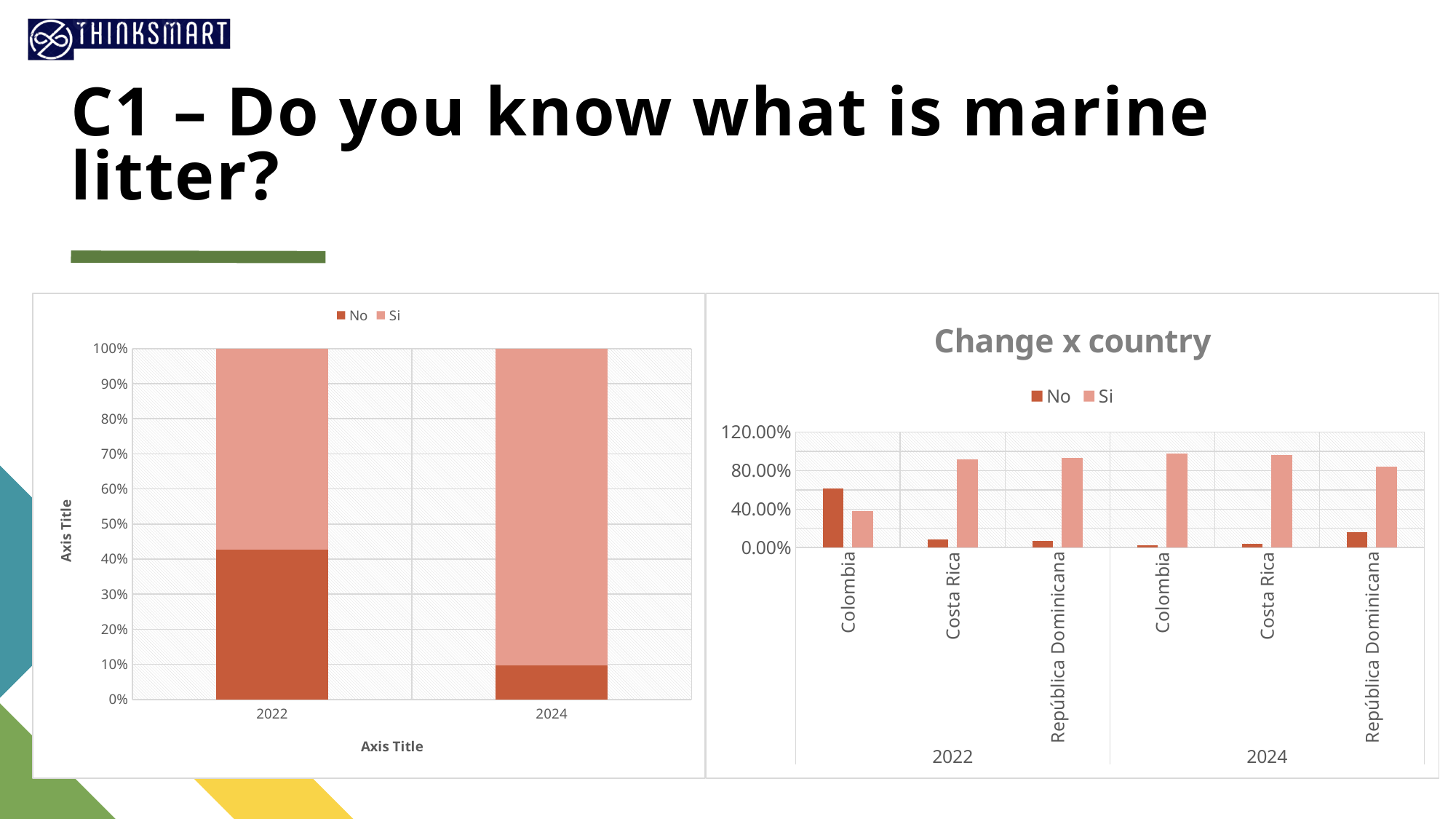
In the 'Change x country' chart, which country has the highest 'No' value in 2022? Colombia In the left chart, does the 'No' share fall or rise from 2022 to 2024? fall What is the title of the right chart? Change x country How many series does the legend of the left chart list? 2 In the left chart, is the 'No' value for 2024 greater or less than 20%? less In the 'Change x country' chart, is the 'Si' value for Costa Rica in 2022 greater or less than 80.00%? greater In the 'Change x country' chart, how many country-year groups are shown on the x axis? 6 What kind of chart is the left chart on the slide? bar chart In the 'Change x country' chart, is the 'No' value for Colombia in 2024 greater or less than 40.00%? less In the 'Change x country' chart, which is larger for Colombia in 2022, 'No' or 'Si'? No In the left chart, which year has the larger 'No' share, 2022 or 2024? 2022